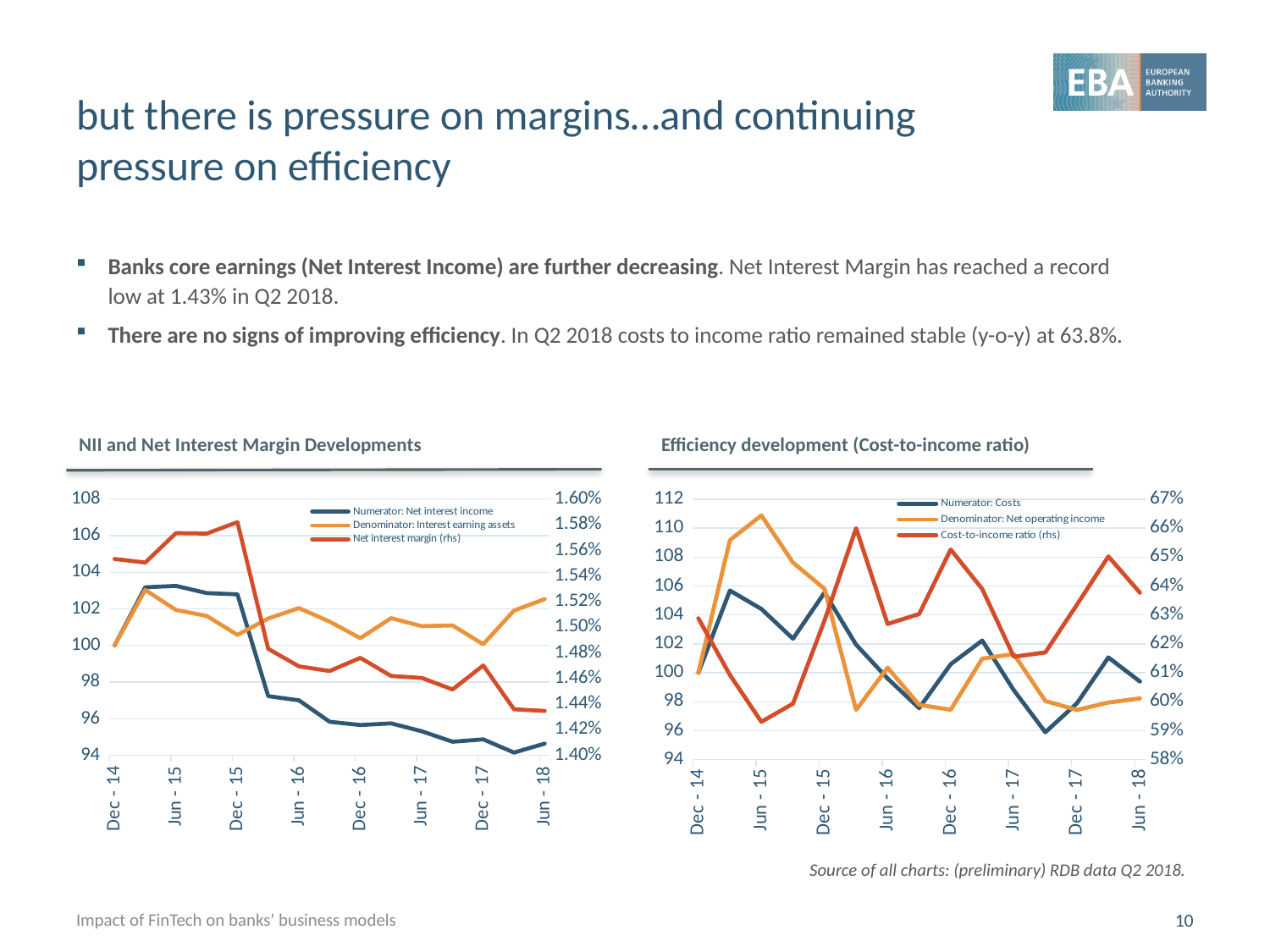
How many series does the legend of the 'Efficiency development (Cost-to-income ratio)' chart list? 3 In the 'Efficiency development (Cost-to-income ratio)' chart, is the value for Net operating income at Jun - 15 greater or less than 108? greater In the 'NII and Net Interest Margin Developments' chart, which series is plotted on the right-hand axis? Net interest margin (rhs) In the 'NII and Net Interest Margin Developments' chart, is the value for Net interest income at Jun - 18 greater or less than 96? less In the 'Efficiency development (Cost-to-income ratio)' chart, which is higher at Jun - 15: Costs or Net operating income? Net operating income In the 'Efficiency development (Cost-to-income ratio)' chart, at which labelled period does Net operating income reach its highest value? Jun - 15 In the 'Efficiency development (Cost-to-income ratio)' chart, what is the first entry in the legend? Numerator: Costs What type of chart is the 'NII and Net Interest Margin Developments' chart? line chart In the 'NII and Net Interest Margin Developments' chart, which series is higher at Jun - 18: Net interest income or Interest earning assets? Interest earning assets In the 'NII and Net Interest Margin Developments' chart, is the Net interest margin at Dec - 15 greater or less than 1.56%? greater In the 'NII and Net Interest Margin Developments' chart, does Net interest income rise or fall overall from Dec - 14 to Jun - 18? fall